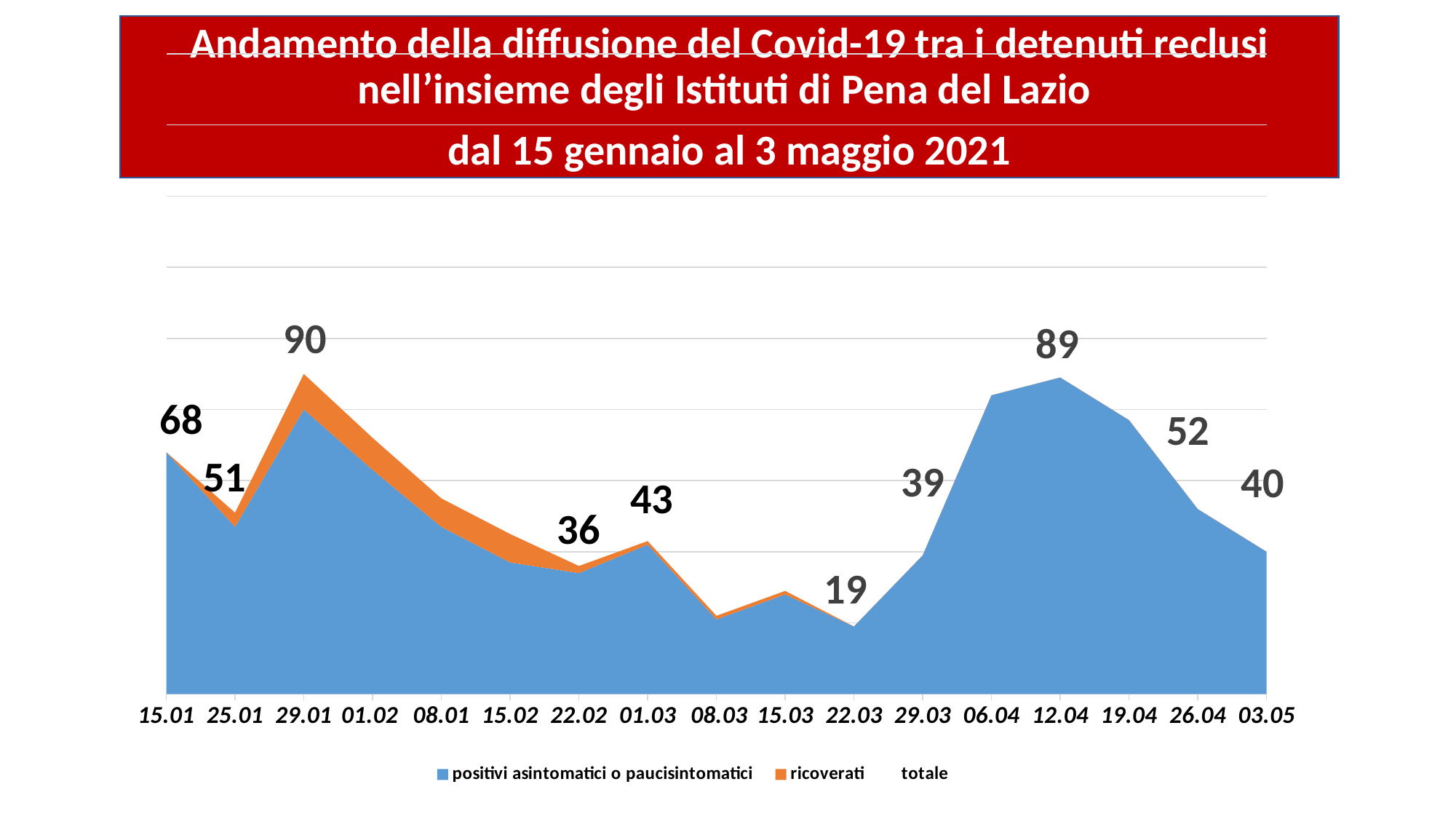
Which is larger, the labelled total for 01.03 or for 22.02? 01.03 Which date has the lowest labelled total? 22.03 What is the total value labelled for 22.03? 19 Which date has the highest labelled total? 29.01 Do the labelled totals rise or fall from 29.01 to 22.03? fall What is the difference between the labelled totals for 15.01 and 25.01? 17 What is the total value labelled for 03.05? 40 How many series does the legend list? 3 How many dates are shown on the x axis? 17 What is the total value labelled for 12.04? 89 What is the difference between the labelled totals for 12.04 and 26.04? 37 What is the total value labelled for 29.01? 90